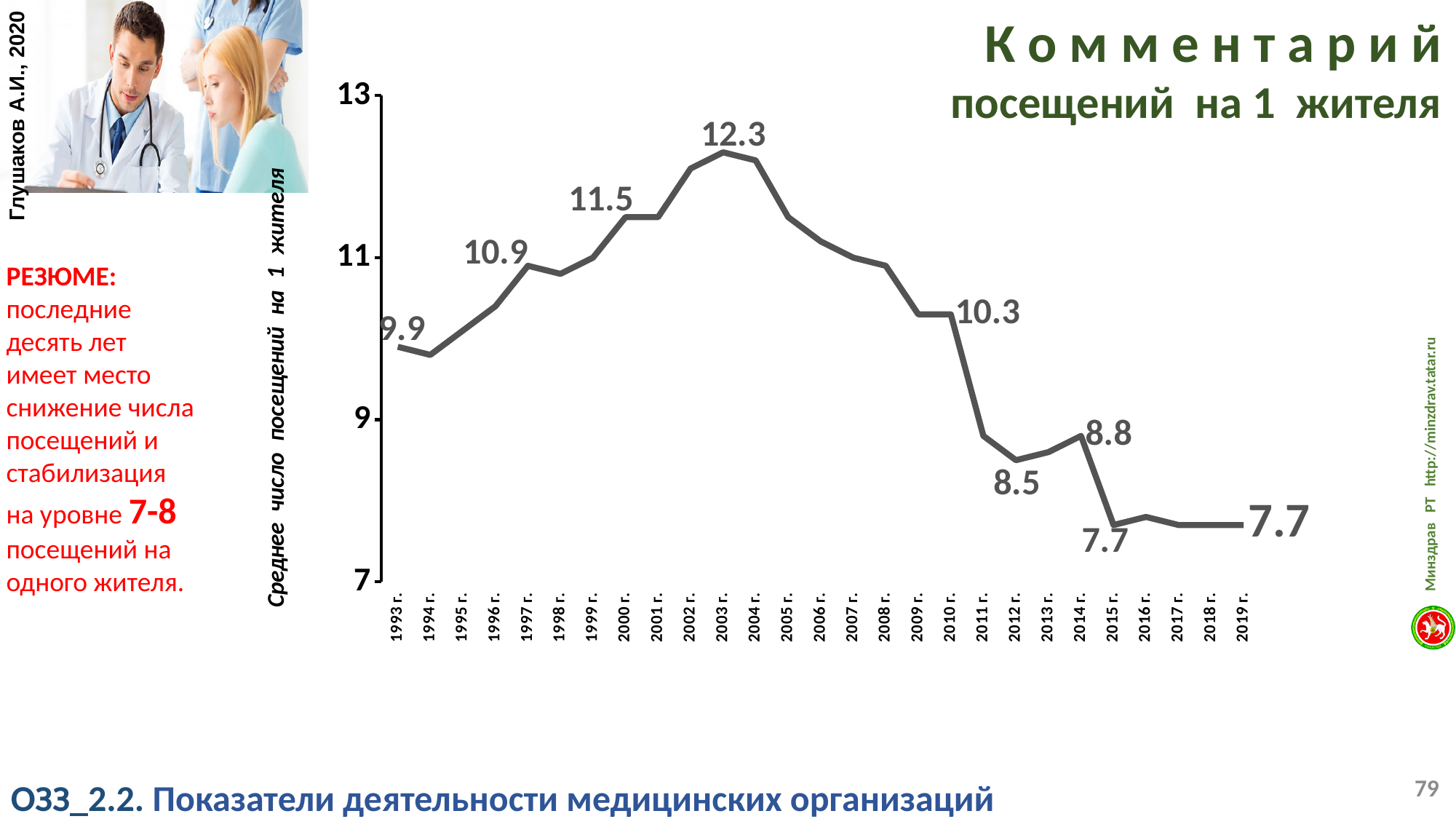
Is the value for 2005 greater or less than 11? greater What kind of chart is shown on the slide? line chart How many years are plotted on the x axis? 27 What is the value shown for 2019? 7.7 What is the difference between the 1993 value and the 2003 value? 2.4 In which year is the number of visits per resident highest? 2003 What is the average number of visits per resident in 2003? 12.3 Which year has the larger value, 1997 or 2012? 1997 By how much did the value fall from 2003 to 2019? 4.6 Is the value for 2011 greater or less than 9? less What is the value shown for 2000? 11.5 What is the value shown for 2012? 8.5